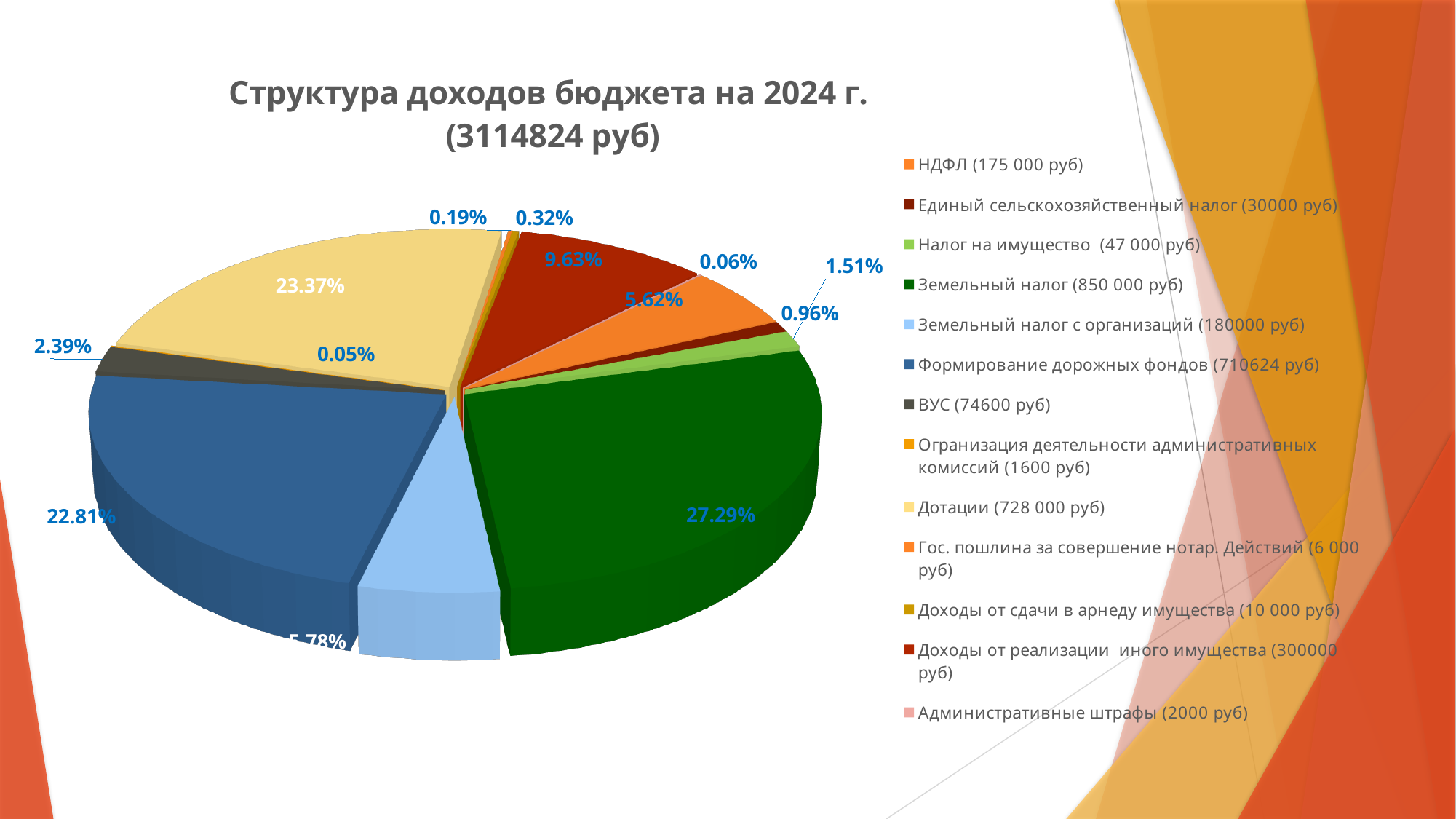
What share of the pie is Дотации? 23.37% What kind of chart is shown on the slide? pie chart What share of the pie is Земельный налог? 27.29% What is the title of the chart? Структура доходов бюджета на 2024 г. (3114824 руб) Which category has the largest share of the pie? Земельный налог Which is larger: the share for Дотации or the share for Формирование дорожных фондов? Дотации What share of the pie is ВУС? 2.39% What share of the pie is Формирование дорожных фондов? 22.81% What is the difference in percentage points between the share for Земельный налог and the share for Дотации? 3.92 How many categories does the legend list? 13 What share of the pie is НДФЛ? 5.62% According to the legend, what amount in rubles corresponds to Земельный налог? 850 000 руб